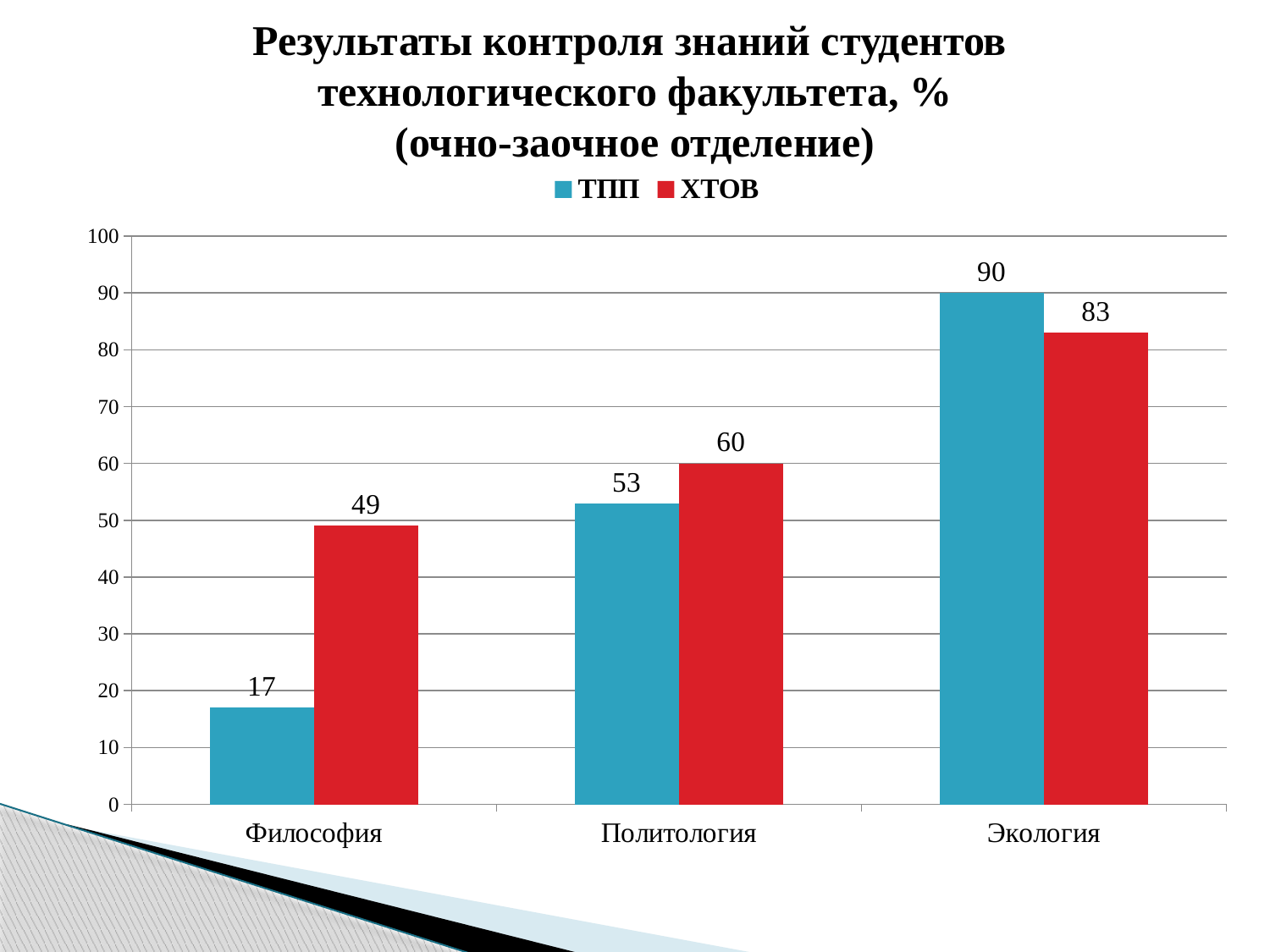
Which is larger in Политология, ТПП or ХТОВ? ХТОВ What is the value for ХТОВ in Политология? 60 Do the ТПП values rise or fall from Философия to Экология? rise Which category has the lowest value for ХТОВ? Философия What is the difference between ХТОВ and ТПП in Философия? 32 Which category has the highest value for ТПП? Экология How many categories are shown on the x axis? 3 What is the difference between ТПП and ХТОВ in Экология? 7 What kind of chart is this? bar chart What is the value for ТПП in Философия? 17 How many series does the legend list? 2 What is the value for ХТОВ in Экология? 83